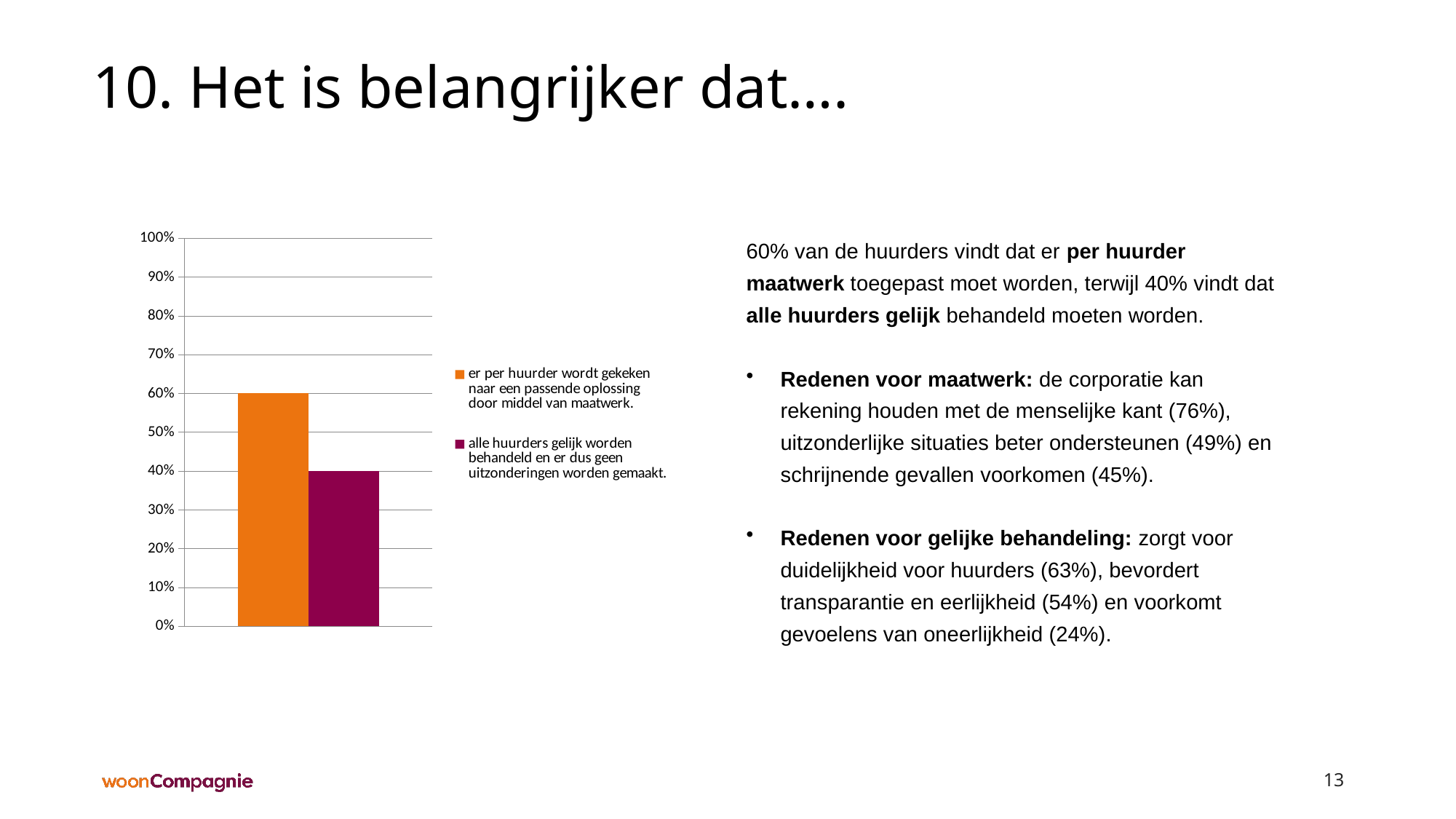
What is the difference between the value for 'per huurder maatwerk' and the value for 'alle huurders gelijk behandeld'? 20% What is the value of the orange bar (er per huurder wordt gekeken naar een passende oplossing door middel van maatwerk)? 60% What kind of chart is shown on the slide? bar chart Is the value of the purple bar greater or less than 50%? less How many bars are plotted in the chart? 2 Which series has the highest value in the chart? er per huurder wordt gekeken naar een passende oplossing door middel van maatwerk What colour is the bar for 'alle huurders gelijk worden behandeld en er dus geen uitzonderingen worden gemaakt'? purple How many series does the chart legend list? 2 What is the maximum value shown on the chart's vertical axis? 100% What is the value of the purple bar (alle huurders gelijk worden behandeld en er dus geen uitzonderingen worden gemaakt)? 40% Which series has the lowest value in the chart? alle huurders gelijk worden behandeld en er dus geen uitzonderingen worden gemaakt Which is larger: the orange bar or the purple bar? the orange bar